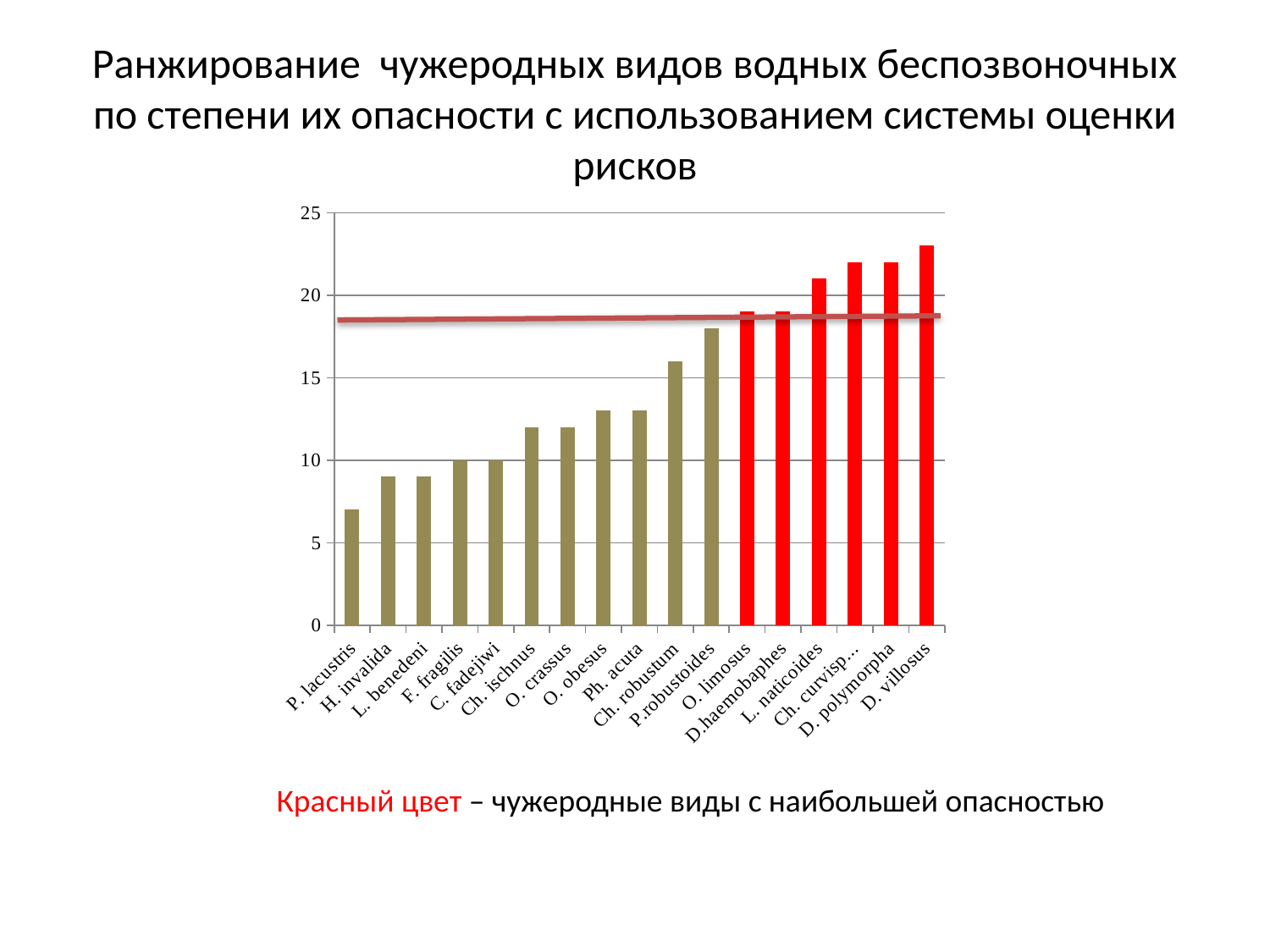
Which species has the highest bar? D. villosus Which species has the lowest bar? P. lacustris According to the slide, what do the red bars represent? чужеродные виды с наибольшей опасностью What is the value for C. fadejiwi? 10 Is the value for Ch. robustum greater or less than 15? greater Is the value for D. villosus greater or less than 20? greater Do the bar values rise or fall from left to right along the x axis? rise Which is larger, the value for D. polymorpha or the value for H. invalida? D. polymorpha What is the value for F. fragilis? 10 How many species (categories) are plotted on the x axis? 17 What kind of chart is shown on the slide? bar chart Is the value for P. lacustris greater or less than 10? less